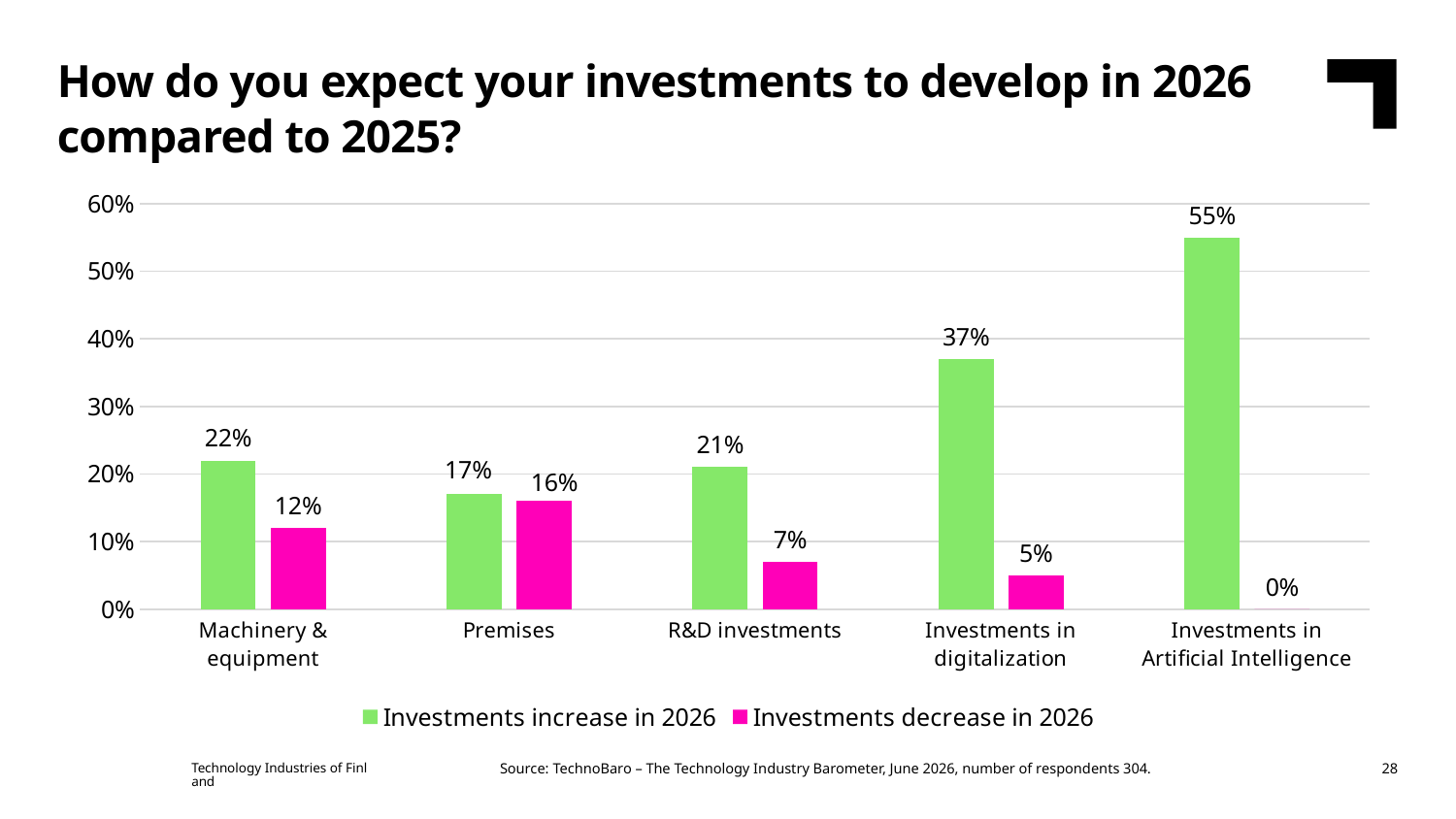
Is the 'Investments increase in 2026' value for Investments in digitalization greater or less than 30%? greater What is the difference between the 'Investments increase in 2026' and 'Investments decrease in 2026' values for Investments in digitalization? 32% What colour represents 'Investments decrease in 2026' in the chart? Pink (magenta) What percentage of respondents expect investments in Premises to decrease in 2026? 16% Which category has the lowest value for 'Investments decrease in 2026'? Investments in Artificial Intelligence What kind of chart is shown on the slide? Bar chart How many investment categories are shown on the x axis? 5 What percentage of respondents expect investments in Artificial Intelligence to increase in 2026? 55% How many series does the legend list? 2 Which category has the highest value for 'Investments increase in 2026'? Investments in Artificial Intelligence Which is larger for Machinery & equipment: the share expecting investments to increase or the share expecting them to decrease in 2026? Investments increase in 2026 What is the value for 'Investments decrease in 2026' for R&D investments? 7%